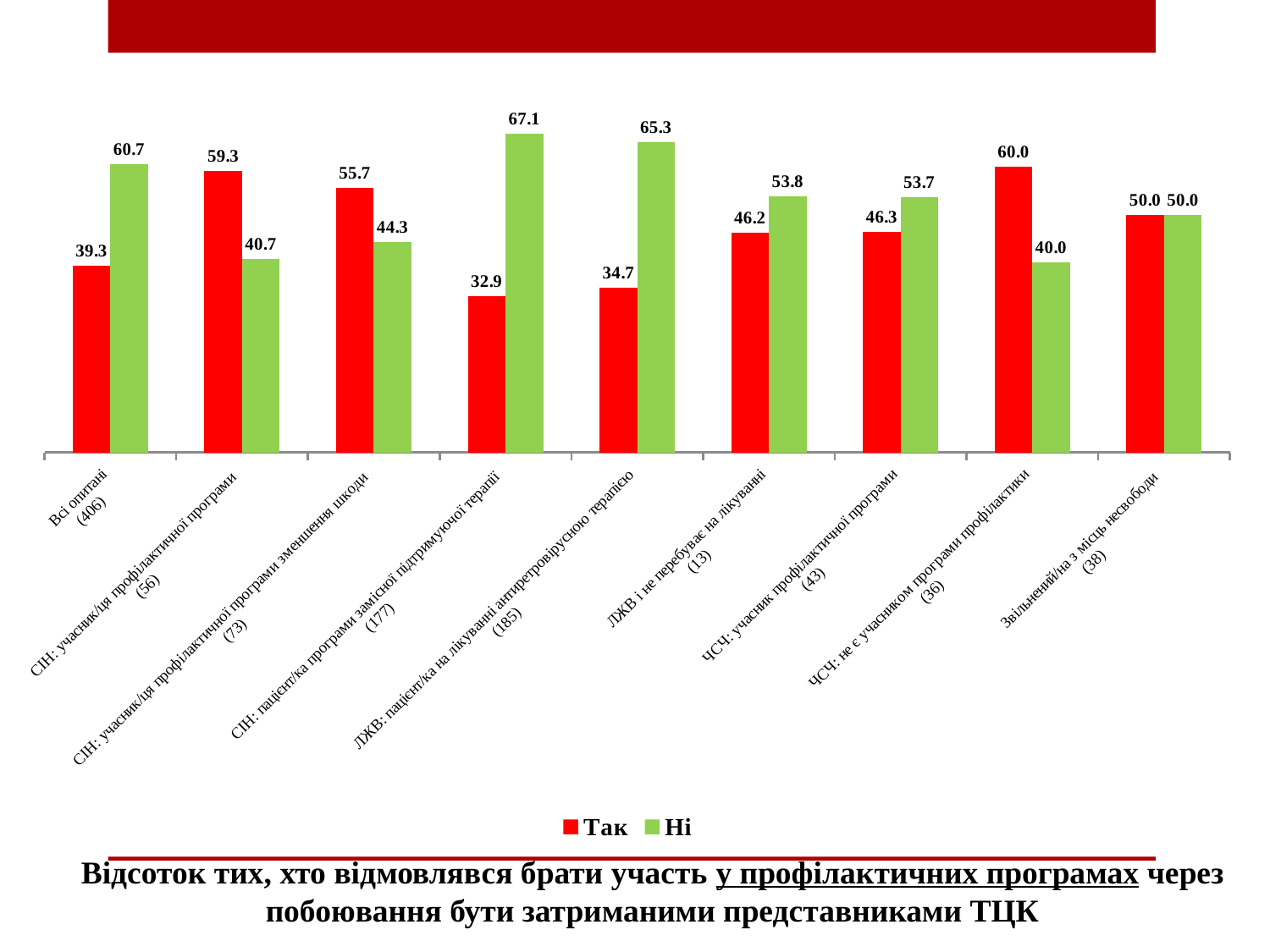
How many series does the legend list? 2 What is the value of "Так" for "ЧСЧ: не є учасником програми профілактики (36)"? 60.0 Which category has the highest value for "Ні"? СІН: пацієнт/ка програми замісної підтримуючої терапії (177) What colour represents the "Так" series? red Which category has the lowest value for "Так"? СІН: пацієнт/ка програми замісної підтримуючої терапії (177) For "СІН: учасник/ця профілактичної програми (56)", which is larger, "Так" or "Ні"? Так What are the values of "Так" and "Ні" for "Звільнений/на з місць несвободи (38)"? 50.0 and 50.0 What is the difference between "Ні" and "Так" for "Всі опитані (406)"? 21.4 What is the value of "Ні" for "СІН: пацієнт/ка програми замісної підтримуючої терапії (177)"? 67.1 What type of chart is shown on the slide? bar chart How many categories are shown on the x axis? 9 What is the value of "Так" for "Всі опитані (406)"? 39.3